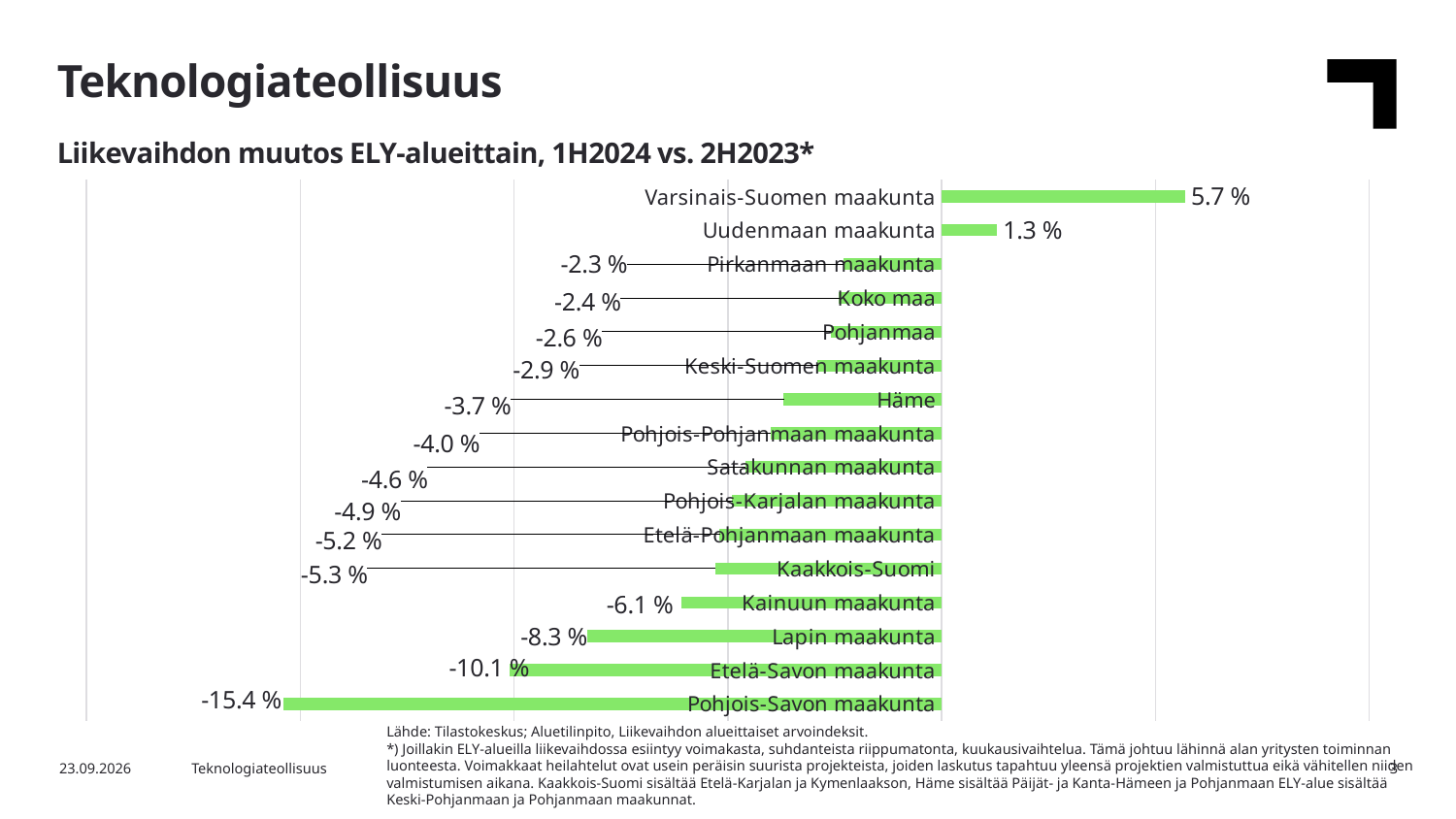
Which region has the lowest value? Pohjois-Savon maakunta What is the difference between the values for Etelä-Savon maakunta and Pohjois-Savon maakunta? 5.3 % What kind of chart is shown on the slide? Bar chart Which has the larger value, Häme or Kainuun maakunta? Häme What is the difference between the values for Varsinais-Suomen maakunta and Uudenmaan maakunta? 4.4 % What is the value for Kaakkois-Suomi? -5.3 % What is the value for Koko maa? -2.4 % What is the title of the chart? Liikevaihdon muutos ELY-alueittain, 1H2024 vs. 2H2023* Which region has the highest value? Varsinais-Suomen maakunta What is the value for Lapin maakunta? -8.3 % What is the value for Varsinais-Suomen maakunta? 5.7 % How many regions are shown in the chart? 16